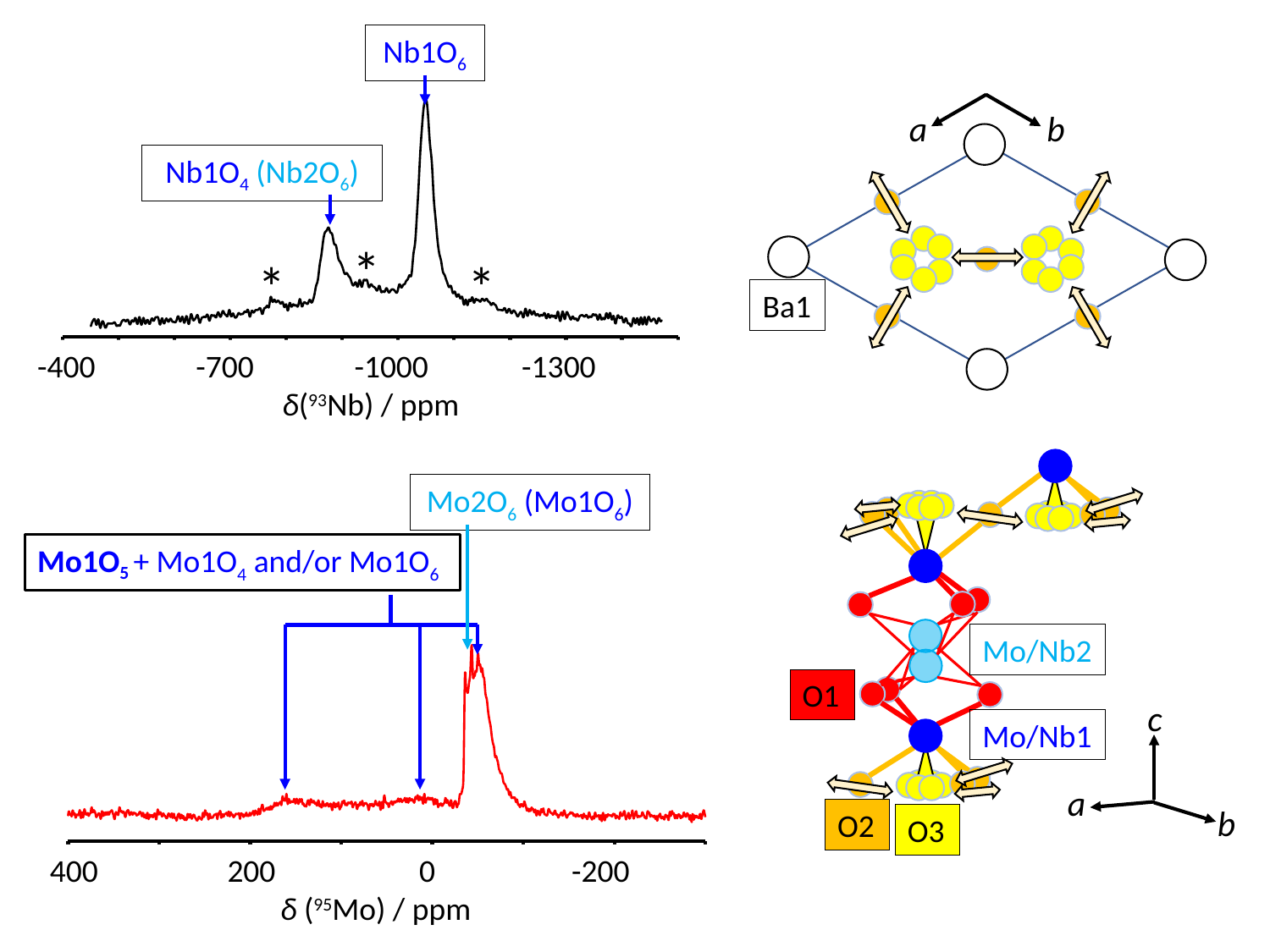
In the top-left 93Nb spectrum, how many peaks are labelled with a species name? 2 What kind of chart is the top-left plot with the δ(93Nb) / ppm axis? line chart In the bottom-left 95Mo spectrum, is the Mo2O6 (Mo1O6) peak located at a chemical shift greater or less than 0 ppm? less In the bottom-left 95Mo spectrum, how many arrows point down onto the spectrum? 4 In the bottom-left 95Mo spectrum, which labelled species corresponds to the most intense peak? Mo2O6 (Mo1O6) In the top-left 93Nb spectrum, which labelled peak is the tallest? Nb1O6 In the bottom-left 95Mo spectrum, is the leftmost blue arrow (Mo1O5 + Mo1O4 and/or Mo1O6) positioned at a chemical shift greater or less than 200 ppm? less In the top-left 93Nb spectrum, is the Nb1O4 (Nb2O6) peak located at a chemical shift greater or less than -1000 ppm? greater In the top-left 93Nb spectrum, how many peaks are marked with an asterisk? 3 What is the x-axis label of the bottom-left spectrum? δ (95Mo) / ppm What is the x-axis label of the top-left spectrum? δ(93Nb) / ppm